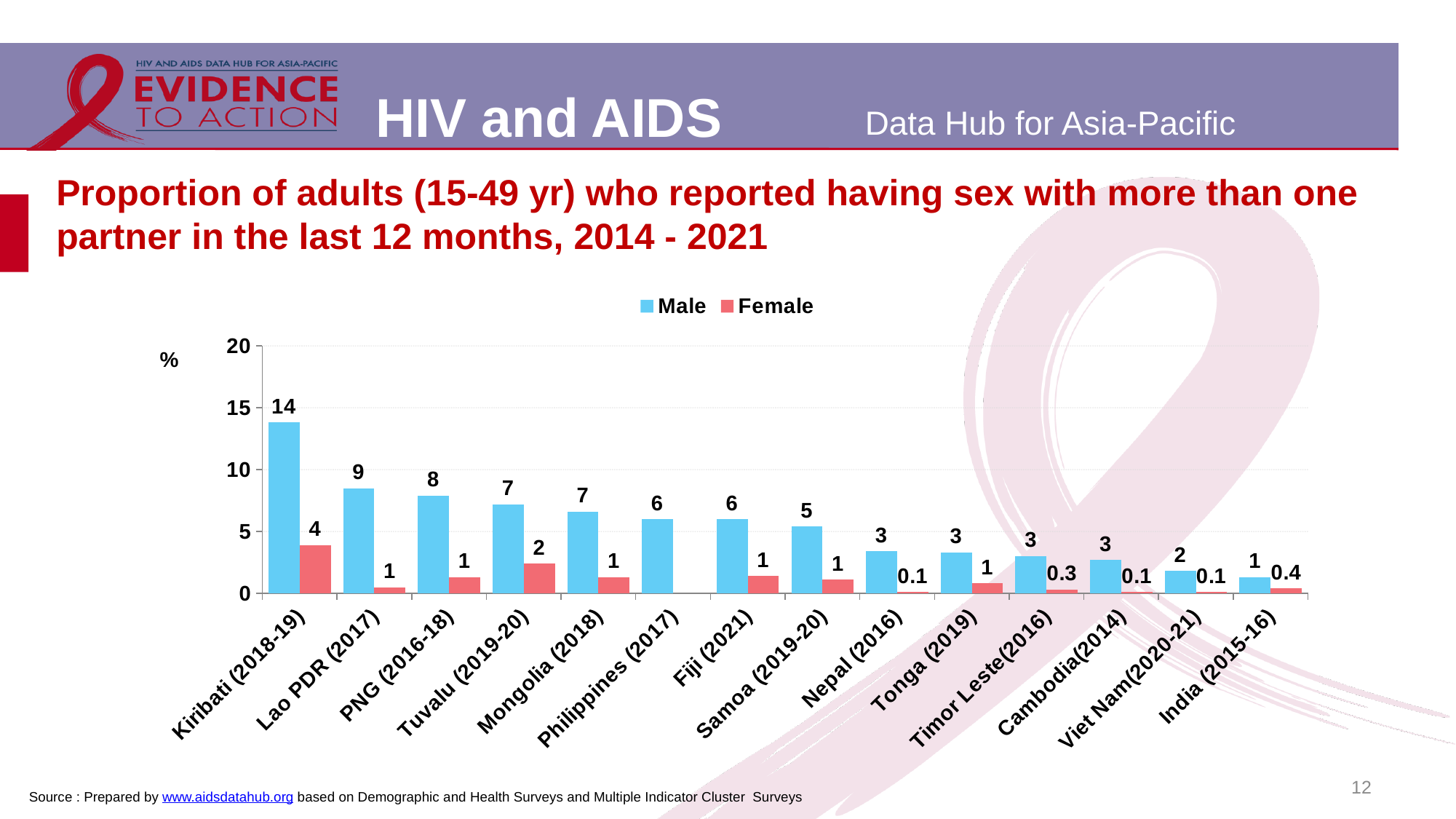
How many series does the legend list? 2 Which is larger, the Male value for Lao PDR (2017) or the Male value for PNG (2016-18)? Lao PDR (2017) Do the Male values rise or fall from left to right along the x axis? fall Which country has the lowest Male value? India (2015-16) What is the Female value for Tuvalu (2019-20)? 2 What is the Male value for Kiribati (2018-19)? 14 What is the Female value for Kiribati (2018-19)? 4 How many countries are shown on the x axis? 14 What is the difference between the Male and Female values for Kiribati (2018-19)? 10 Which country has the highest Male value? Kiribati (2018-19) What is the Female value for Timor Leste (2016)? 0.3 Is the Male value for Kiribati (2018-19) greater or less than 10? greater